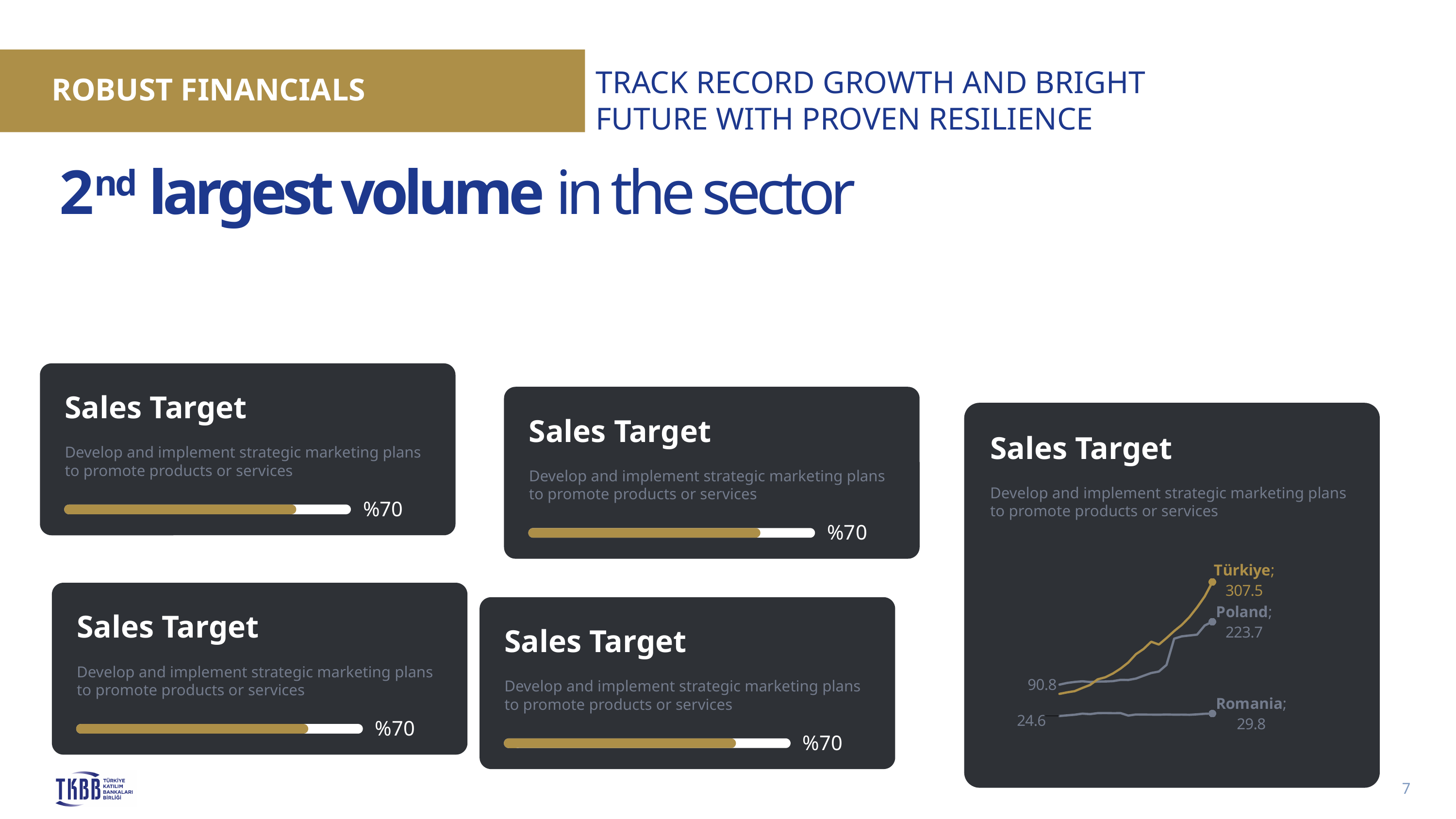
What type of chart is shown in the bottom-right card? Line chart In the line chart in the bottom-right card, what is the starting value labelled on the Romania line? 24.6 In the line chart in the bottom-right card, what is the final value shown for Türkiye? 307.5 In the line chart in the bottom-right card, what is the difference between the final values of Poland and Romania? 193.9 In the line chart in the bottom-right card, by how much did Romania's value increase from its starting value to its final value? 5.2 In the line chart in the bottom-right card, which country has the lowest final value? Romania In the line chart in the bottom-right card, what is the final value shown for Romania? 29.8 In the line chart in the bottom-right card, which has the larger final value, Türkiye or Poland? Türkiye In the line chart in the bottom-right card, which country has the highest final value? Türkiye In the line chart in the bottom-right card, what is the difference between the final values of Türkiye and Poland? 83.8 In the line chart in the bottom-right card, what is the final value shown for Poland? 223.7 How many country series are plotted in the line chart in the bottom-right card? 3